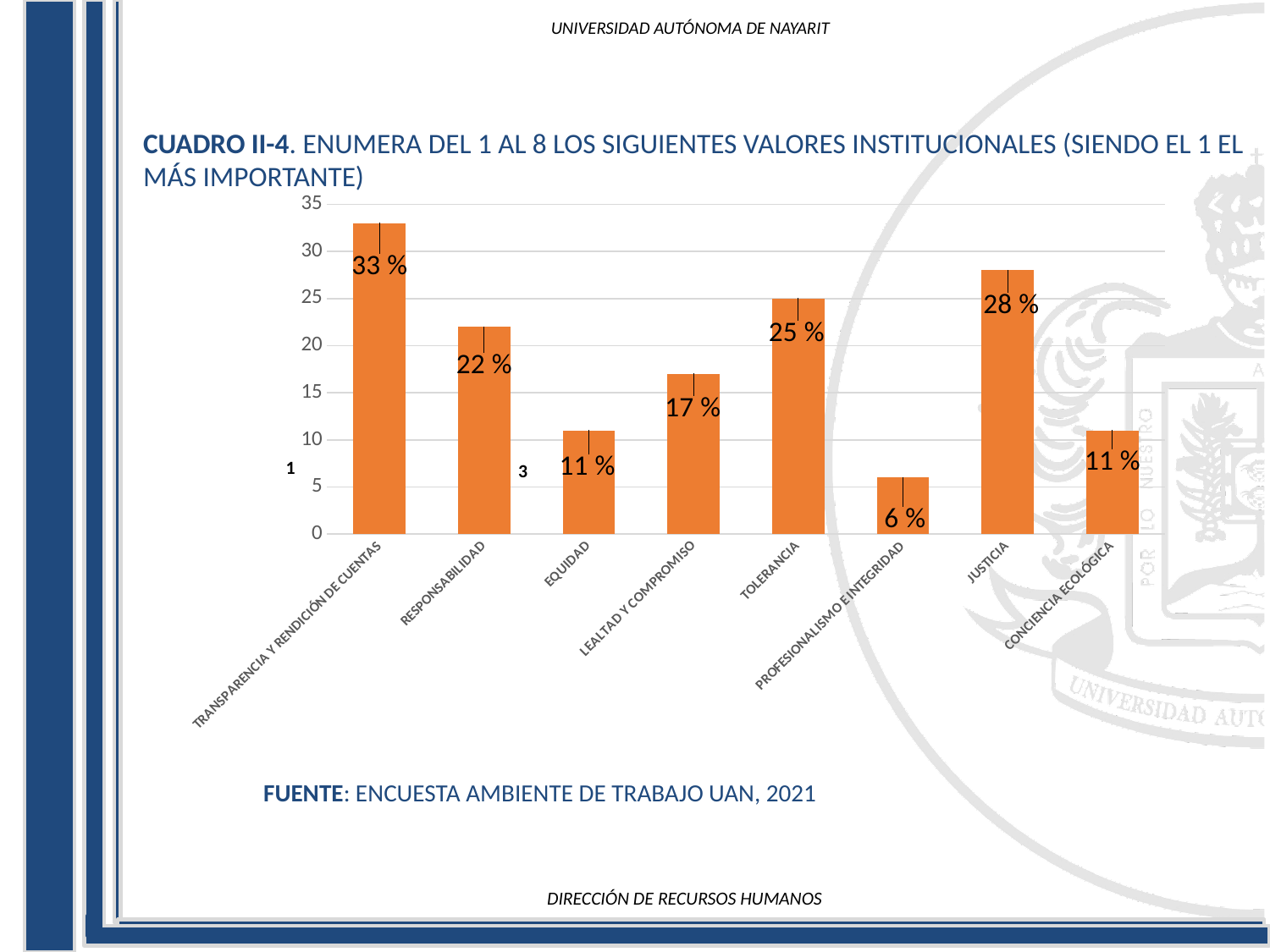
What is the value shown for TRANSPARENCIA Y RENDICIÓN DE CUENTAS? 33 % What kind of chart is shown on the slide? bar chart What is the value shown for TOLERANCIA? 25 % What is the value shown for JUSTICIA? 28 % What is the value shown for PROFESIONALISMO E INTEGRIDAD? 6 % Is the value for RESPONSABILIDAD greater or less than 20? greater What source is cited below the chart? ENCUESTA AMBIENTE DE TRABAJO UAN, 2021 What is the difference between the values for JUSTICIA and RESPONSABILIDAD? 6 % Which category has the highest value? TRANSPARENCIA Y RENDICIÓN DE CUENTAS Which is larger, the value for LEALTAD Y COMPROMISO or the value for EQUIDAD? LEALTAD Y COMPROMISO How many categories are shown on the x axis? 8 Which category has the lowest value? PROFESIONALISMO E INTEGRIDAD